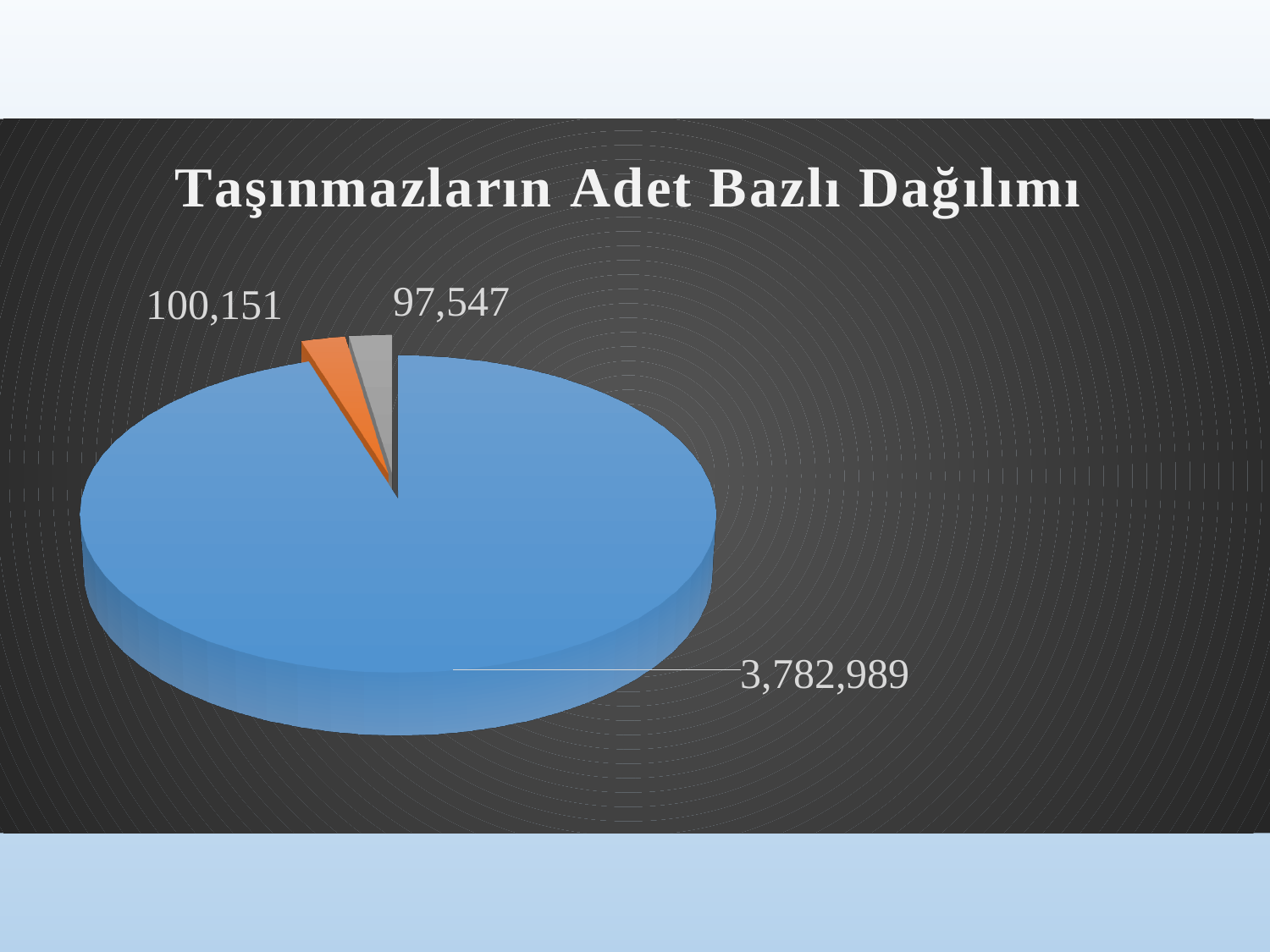
What is the value shown for the gray slice? 97,547 What is the difference between the blue slice (3,782,989) and the orange slice (100,151)? 3,682,838 What is the difference between the orange slice (100,151) and the gray slice (97,547)? 2,604 What is the value of the largest slice of the pie? 3,782,989 How many slices does the pie chart have? 3 Which is larger, the orange slice (100,151) or the gray slice (97,547)? The orange slice (100,151) What is the total of all three slices in the pie chart? 3,980,687 What kind of chart is shown on the slide? Pie chart What is the title of the chart? Taşınmazların Adet Bazlı Dağılımı What is the value shown for the orange slice? 100,151 What colour is the largest slice of the pie? Blue What is the value of the smallest slice of the pie? 97,547